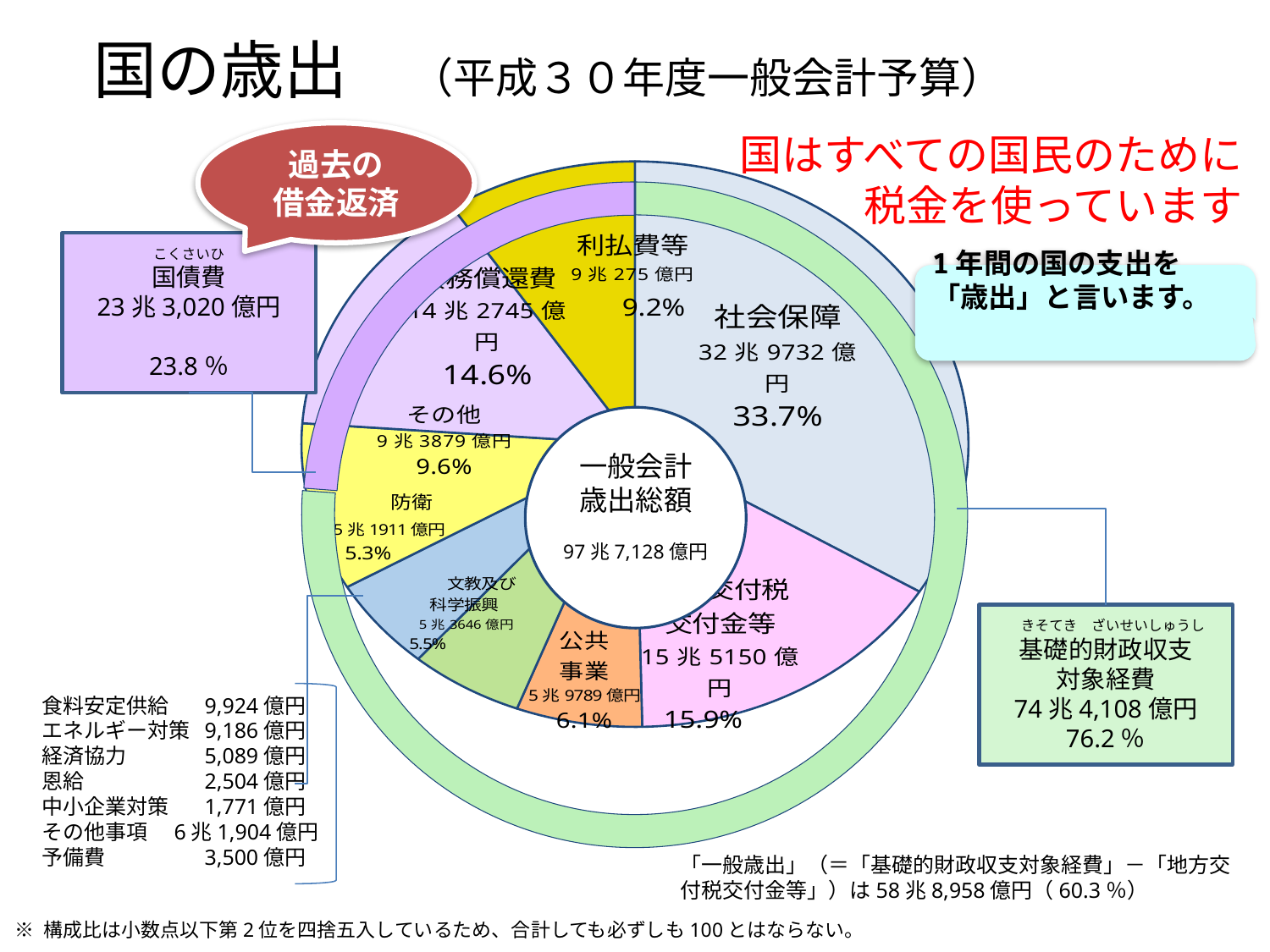
What percentage is shown for 防衛 in the pie chart? 5.3% What percentage is shown for 債務償還費 in the pie chart? 14.6% What is the amount shown for 公共事業 in the pie chart? 5兆9789億円 What is the difference in percentage points between 社会保障 (33.7%) and 地方交付税交付金等 (15.9%)? 17.8 What is the total amount shown in the center of the pie chart (一般会計歳出総額)? 97兆7,128億円 What is the amount shown for 地方交付税交付金等 in the pie chart? 15兆5150億円 What type of chart is shown on the slide? Pie chart Which category has the smallest share of the pie chart? 防衛 How many categories (slices) are shown in the pie chart? 8 What percentage of the total expenditure does 社会保障 account for in the pie chart? 33.7% Which category has the largest share of the pie chart? 社会保障 Which is larger in the pie chart, 利払費等 or その他? その他